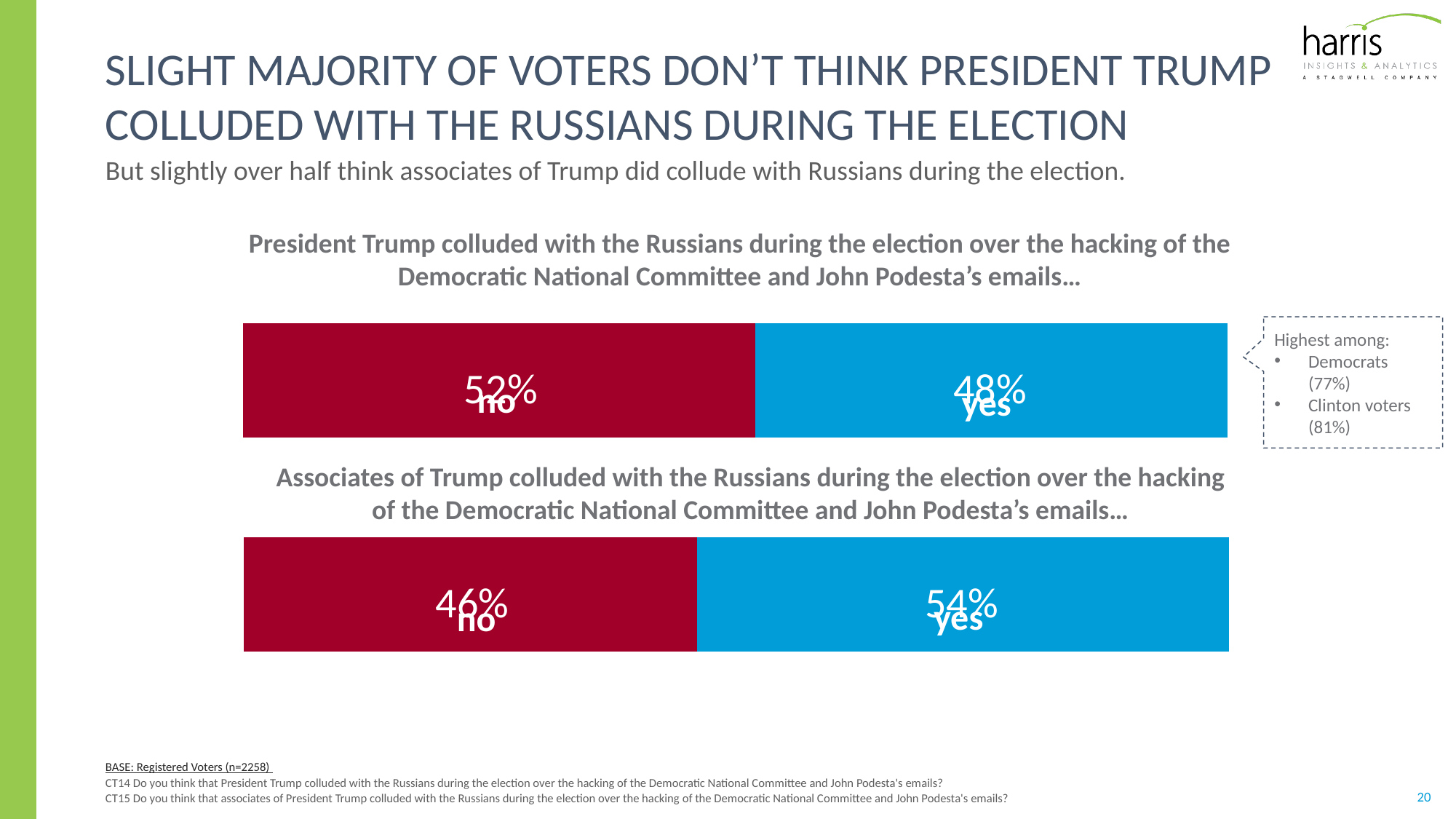
How many segments does the bottom chart about associates of Trump colluding with the Russians have? 2 In the top chart about President Trump colluding with the Russians, what is the difference between the "no" and "yes" percentages? 4% In the bottom chart about associates of Trump colluding with the Russians, what percentage answered "no"? 46% In the bottom chart about associates of Trump colluding with the Russians, what is the difference between the "yes" and "no" percentages? 8% In the bottom chart about associates of Trump colluding with the Russians, which response is larger, "no" or "yes"? yes What type of chart is used for the top chart about President Trump colluding with the Russians? Stacked bar chart In the top chart about President Trump colluding with the Russians, which response is larger, "no" or "yes"? no In the top chart about President Trump colluding with the Russians, what percentage answered "yes"? 48% What is the total of the two segments in the bottom chart about associates of Trump colluding with the Russians? 100% In the bottom chart about associates of Trump colluding with the Russians, what percentage answered "yes"? 54% In the top chart about President Trump colluding with the Russians, what percentage answered "no"? 52% In the top chart about President Trump colluding with the Russians, what colour is the "yes" segment? Blue